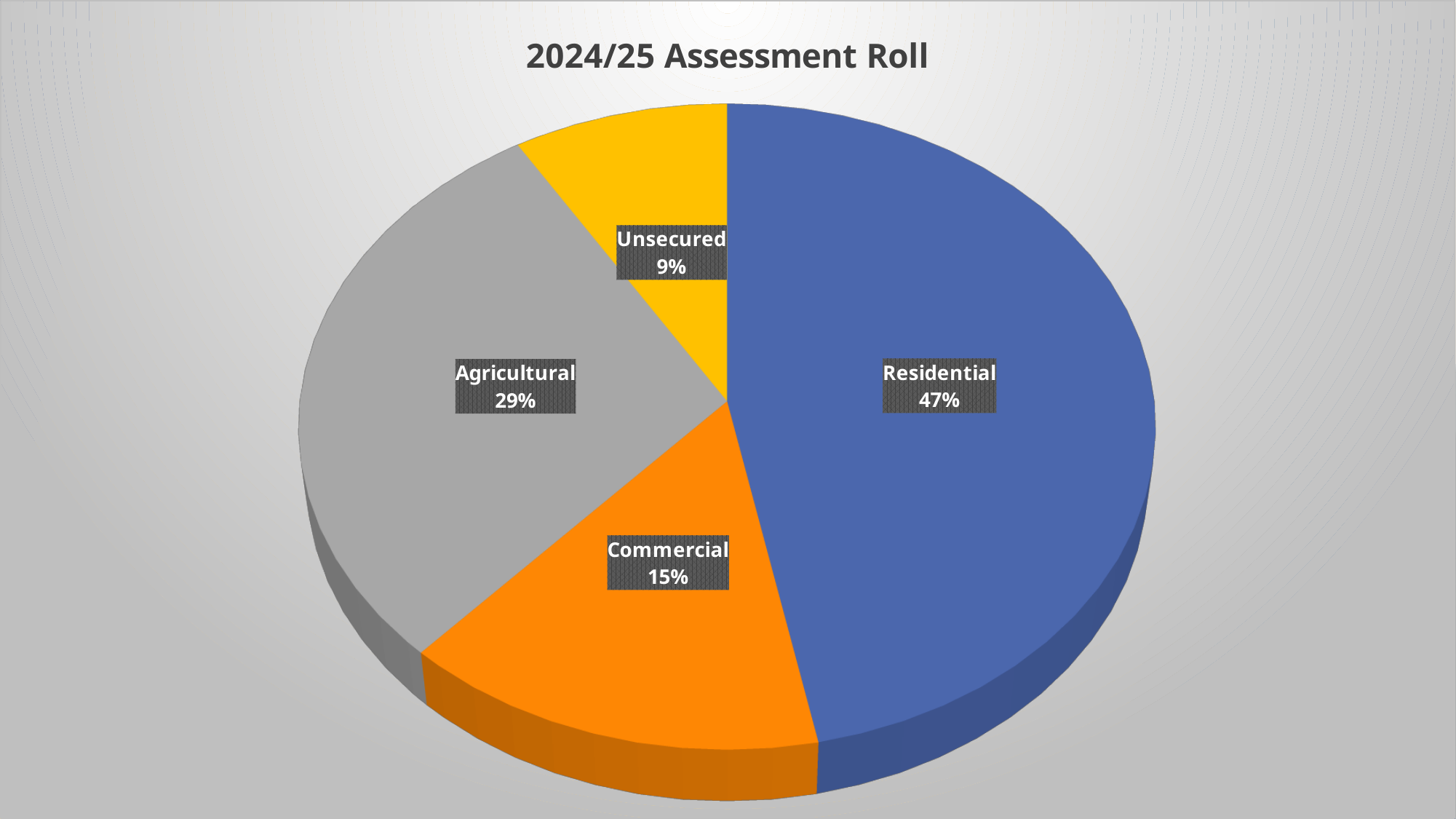
Which is larger, the Agricultural slice or the Commercial slice? Agricultural What share of the 2024/25 Assessment Roll is Unsecured? 9% What is the title of the chart? 2024/25 Assessment Roll How many categories are shown in the pie chart? 4 What share of the 2024/25 Assessment Roll is Commercial? 15% What is the difference in percentage points between Commercial and Unsecured? 6 What is the difference in percentage points between Residential and Agricultural? 18 Which category has the smallest slice of the pie? Unsecured What kind of chart is shown on the slide? Pie chart Which category has the largest slice of the pie? Residential What share of the 2024/25 Assessment Roll is Residential? 47%